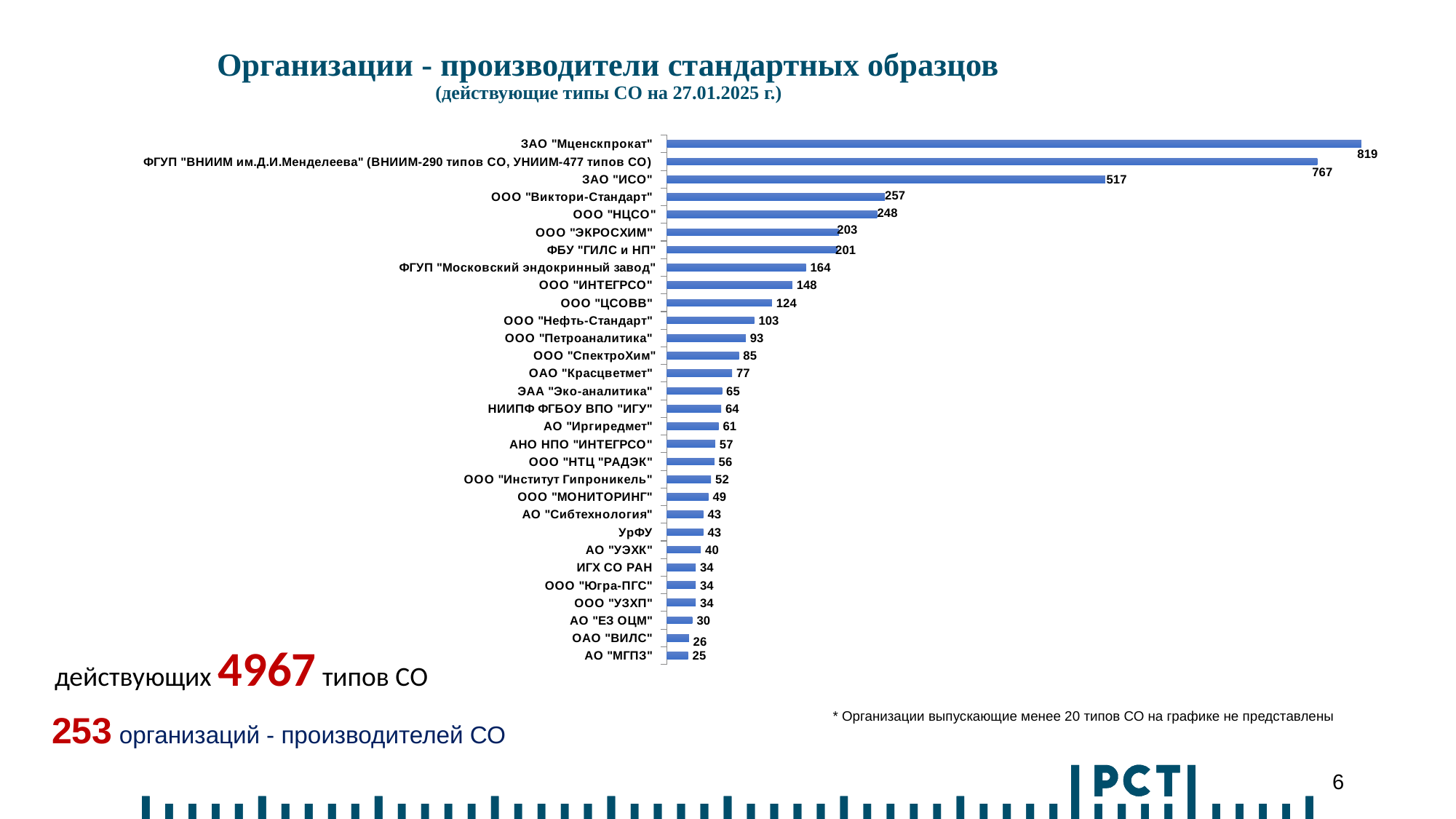
Which organization has the highest value on the chart? ЗАО "Мценскпрокат" What kind of chart is shown on the slide? Bar chart What is the value for ООО "Виктори-Стандарт"? 257 What is the difference between the values for ООО "НЦСО" and ООО "ЭКРОСХИМ"? 45 What is the value for ФГУП "Московский эндокринный завод"? 164 How many organizations are shown on the chart? 30 What is the difference between the values for ЗАО "Мценскпрокат" and ЗАО "ИСО"? 302 What is the value for ЗАО "Мценскпрокат"? 819 What is the date given in the chart subtitle? 27.01.2025 What is the value for АО "УЭХК"? 40 Which has a larger value, ООО "ИНТЕГРСО" or ООО "ЦСОВВ"? ООО "ИНТЕГРСО" Which organization has the lowest value on the chart? АО "МГПЗ"